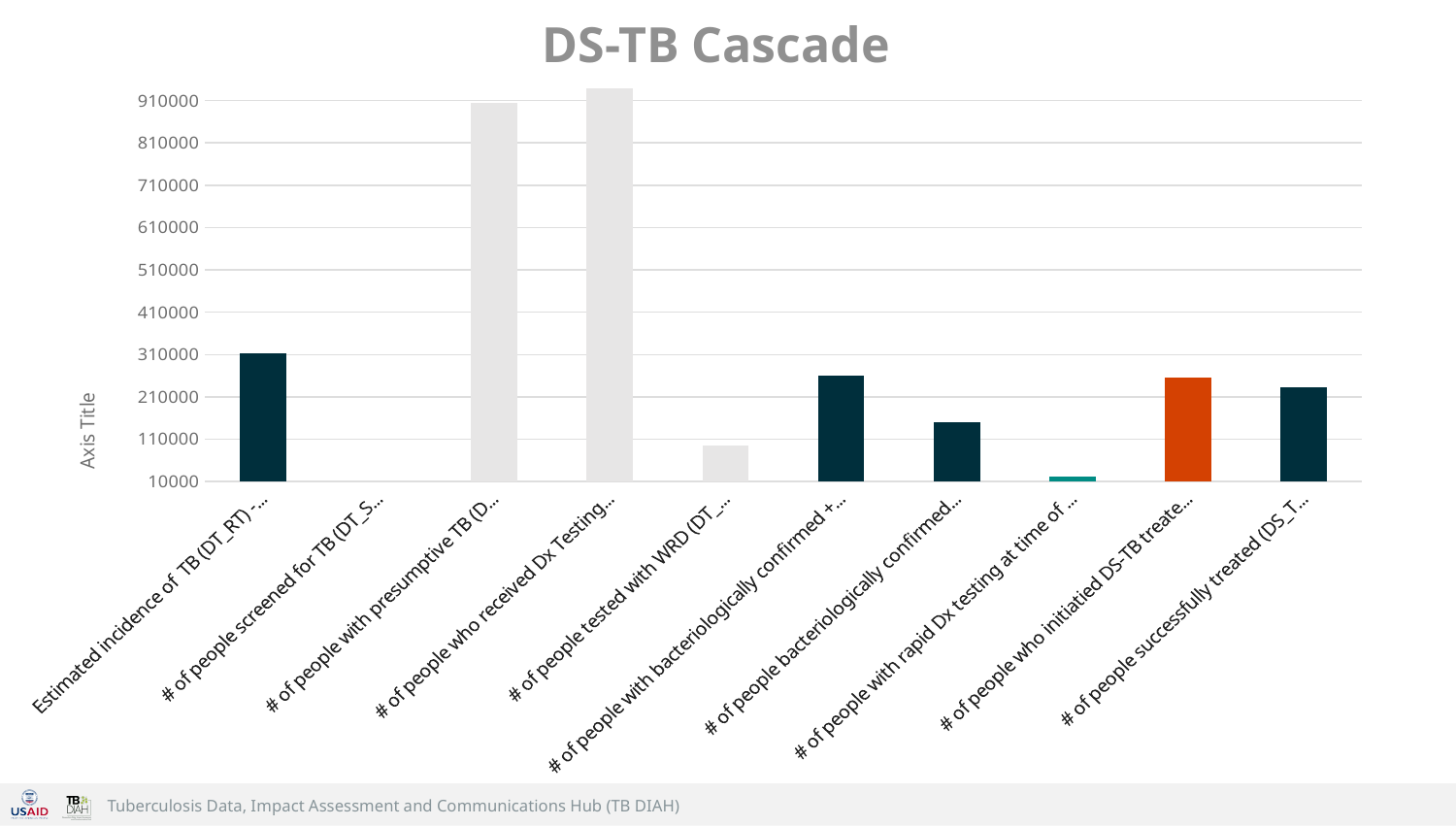
How many categories are shown along the x axis of the chart? 10 Is the value for '# of people who initiatied DS-TB treate...' greater or less than 210000? greater What kind of chart is shown on the slide? Bar chart Is the value for '# of people with rapid Dx testing at time of ...' greater or less than 110000? less What is the title of the chart? DS-TB Cascade Which is larger: the value for 'Estimated incidence of TB (DT_RT)' or the value for '# of people bacteriologically confirmed...'? Estimated incidence of TB (DT_RT) Is the value for '# of people tested with WRD' greater or less than 110000? less Which is larger: the value for '# of people who initiatied DS-TB treate...' or the value for '# of people successfully treated (DS_T...'? # of people who initiatied DS-TB treate... What colour is the bar for '# of people who initiatied DS-TB treate...'? Orange Which category has the tallest bar in the chart? # of people who received Dx Testing